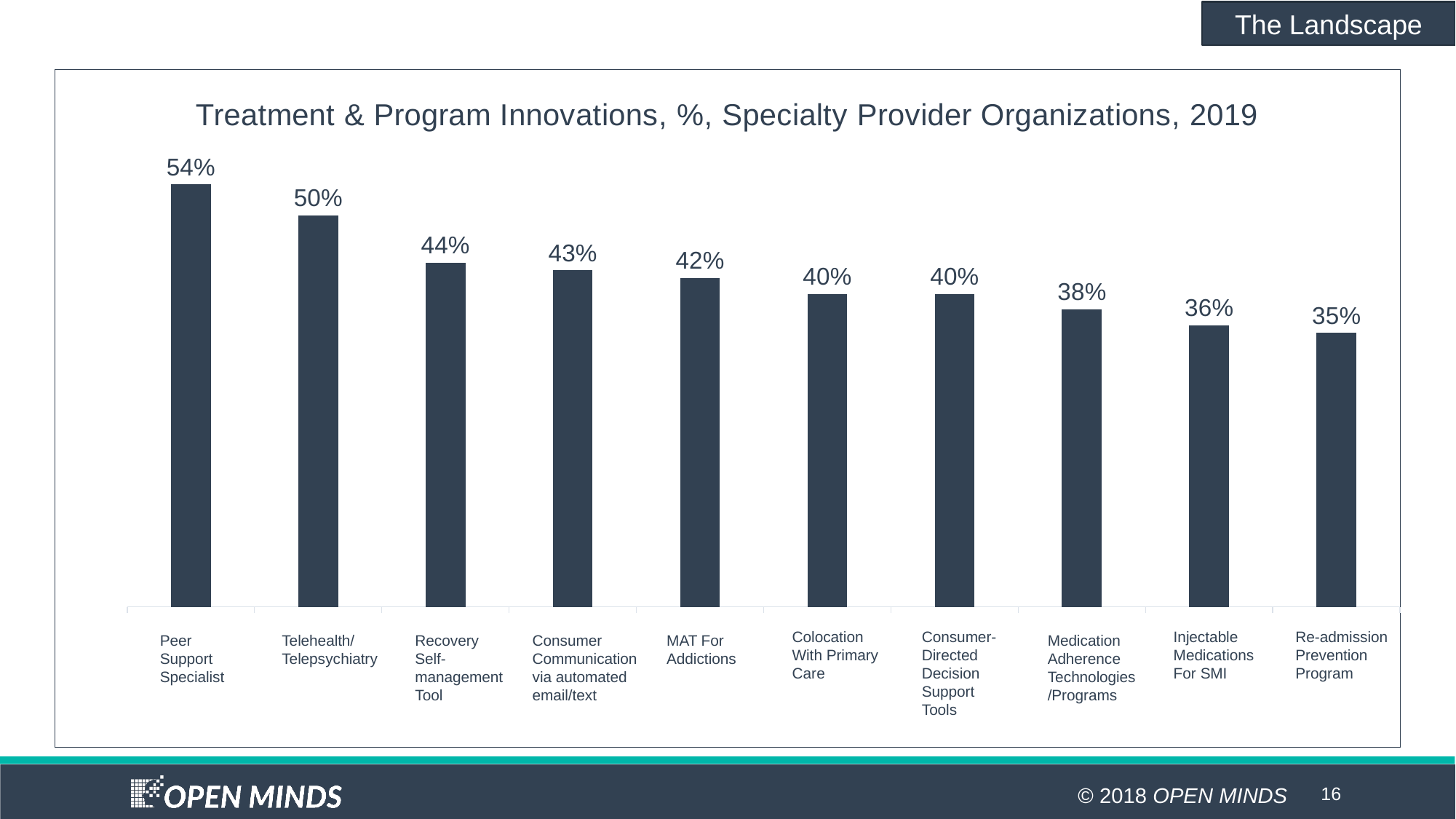
Do the values rise or fall from left to right along the x axis? Fall Which category has the highest value? Peer Support Specialist Which category has the lowest value? Re-admission Prevention Program What is the difference between Peer Support Specialist and Telehealth/Telepsychiatry? 4% What is the value for Injectable Medications For SMI? 36% What is the value for Peer Support Specialist? 54% What is the title of the chart? Treatment & Program Innovations, %, Specialty Provider Organizations, 2019 What is the difference between Recovery Self-management Tool and Re-admission Prevention Program? 9% What is the value for MAT For Addictions? 42% How many categories are shown in the chart? 10 Which is larger, Consumer Communication via automated email/text or Medication Adherence Technologies/Programs? Consumer Communication via automated email/text What kind of chart is this? Bar chart